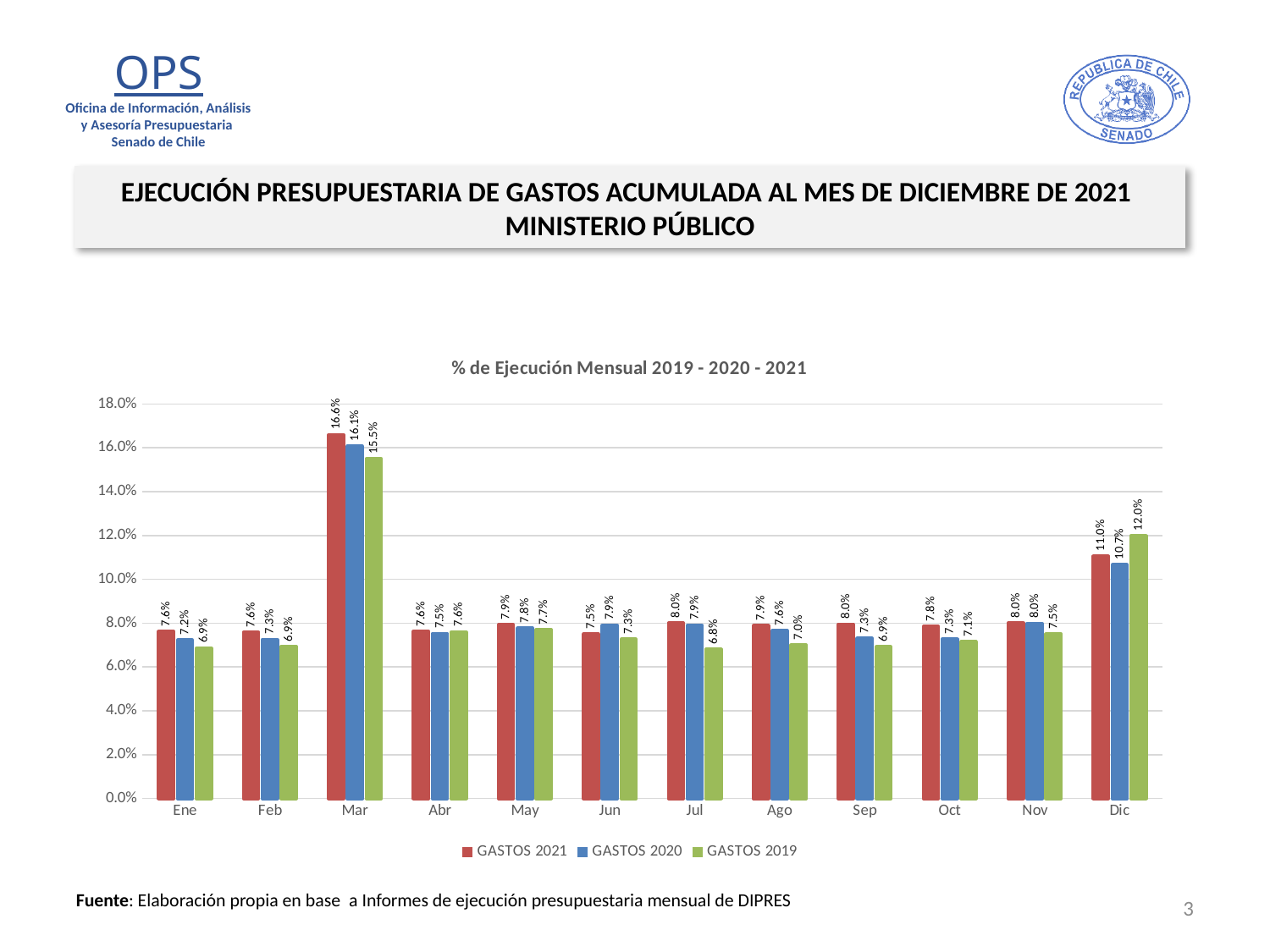
What kind of chart is shown? Bar chart Which month has the lowest value for GASTOS 2019? Jul What is the value for GASTOS 2019 in Dic? 12.0% Is the value for GASTOS 2020 in Dic greater or less than 10.0%? greater What is the value for GASTOS 2021 in Mar? 16.6% Which month has the highest value for GASTOS 2020? Mar What is the title of the chart? % de Ejecución Mensual 2019 - 2020 - 2021 How many months are shown on the x axis? 12 In Dic, which series has the larger value, GASTOS 2021 or GASTOS 2019? GASTOS 2019 What is the difference between GASTOS 2021 and GASTOS 2019 in Mar? 1.1% What is the value for GASTOS 2020 in Jun? 7.9% How many series does the legend list? 3